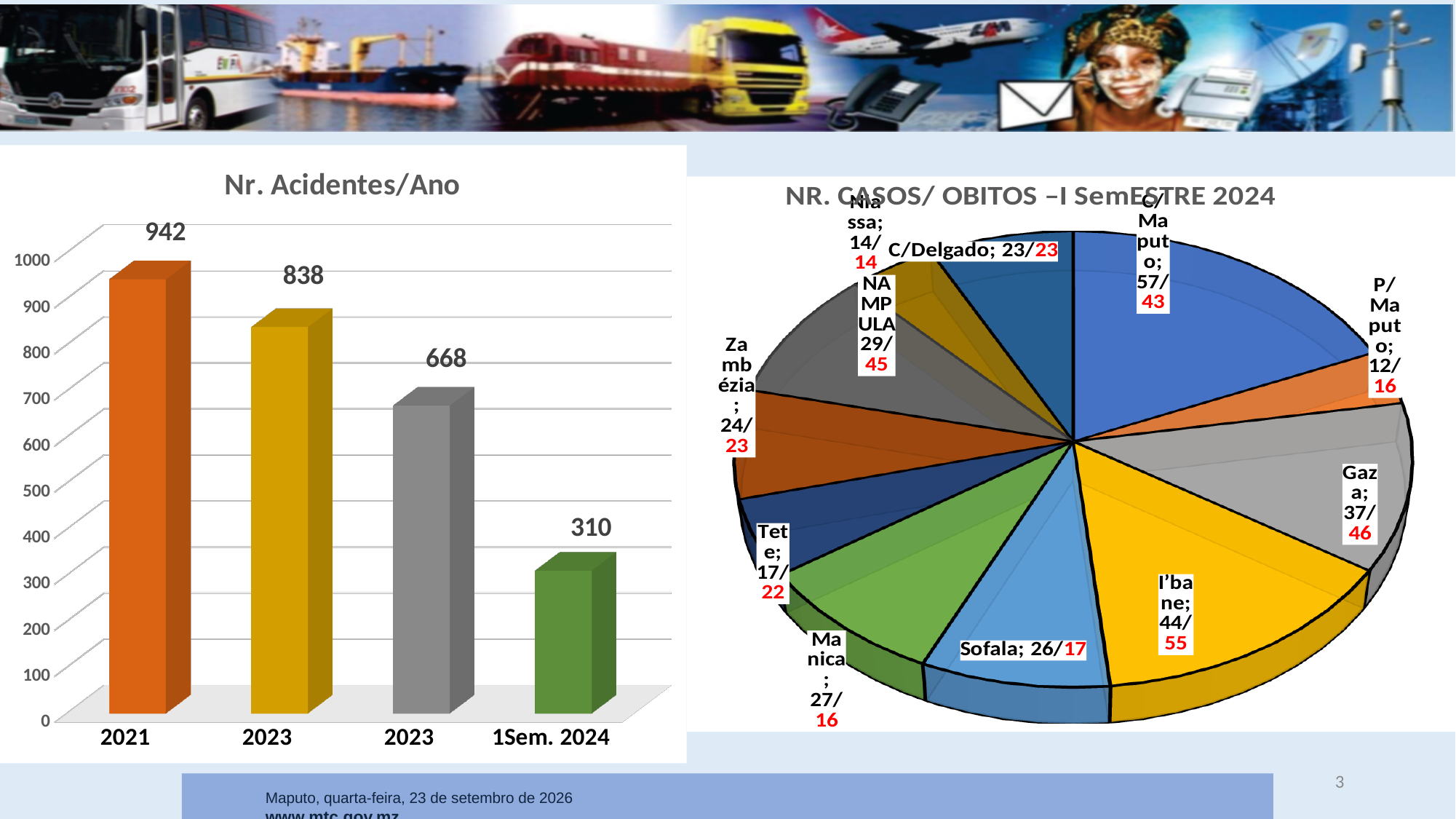
What kind of chart is the 'NR. CASOS/ OBITOS – I SemESTRE 2024' chart on the right? pie chart In the 'Nr. Acidentes/Ano' chart, what is the difference between the value for 2021 and the value for 1Sem. 2024? 632 In the 'Nr. Acidentes/Ano' chart, do the values rise or fall from left to right along the x axis? fall In the 'NR. CASOS/ OBITOS – I SemESTRE 2024' pie chart, what is the label value shown for Gaza? 37/46 How many bars are shown in the 'Nr. Acidentes/Ano' chart? 4 In the 'Nr. Acidentes/Ano' chart, what is the value for 2021? 942 In the 'Nr. Acidentes/Ano' chart, which category has the lowest value? 1Sem. 2024 How many slices does the 'NR. CASOS/ OBITOS – I SemESTRE 2024' pie chart have? 11 What kind of chart is the 'Nr. Acidentes/Ano' chart on the left? bar chart In the 'Nr. Acidentes/Ano' chart, what is the value for 1Sem. 2024? 310 In the 'Nr. Acidentes/Ano' chart, which category has the highest value? 2021 In the 'NR. CASOS/ OBITOS – I SemESTRE 2024' pie chart, what is the label value shown for Sofala? 26/17